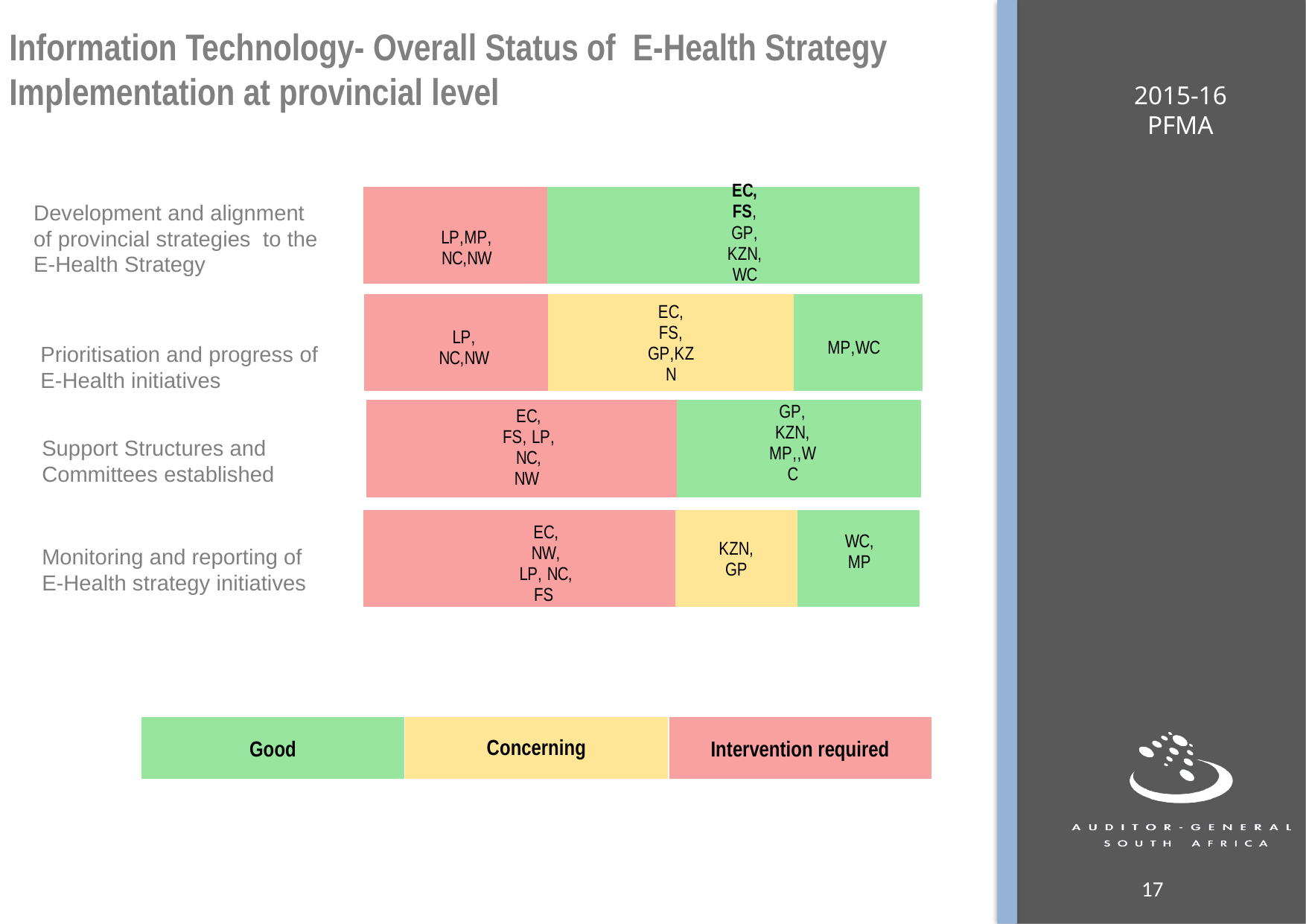
For 'Prioritisation and progress of E-Health initiatives', are more provinces rated 'Concerning' or 'Good'? Concerning Which provinces are rated 'Intervention required' for 'Development and alignment of provincial strategies to the E-Health Strategy'? LP, MP, NC, NW How many E-Health strategy areas (rows) does the chart show? 4 Which status does the green colour represent in the legend? Good Which provinces are rated 'Good' for 'Prioritisation and progress of E-Health initiatives'? MP, WC How many status categories does the legend list? 3 What kind of chart is shown on the slide? Bar chart (horizontal stacked bars) Which provinces are rated 'Good' for 'Support Structures and Committees established'? GP, KZN, MP, WC How many provinces are rated 'Intervention required' for 'Monitoring and reporting of E-Health strategy initiatives'? 5 Which provinces are rated 'Concerning' for 'Monitoring and reporting of E-Health strategy initiatives'? KZN, GP Which strategy area has the most provinces rated 'Good'? Development and alignment of provincial strategies to the E-Health Strategy Which status does the red colour represent in the legend? Intervention required